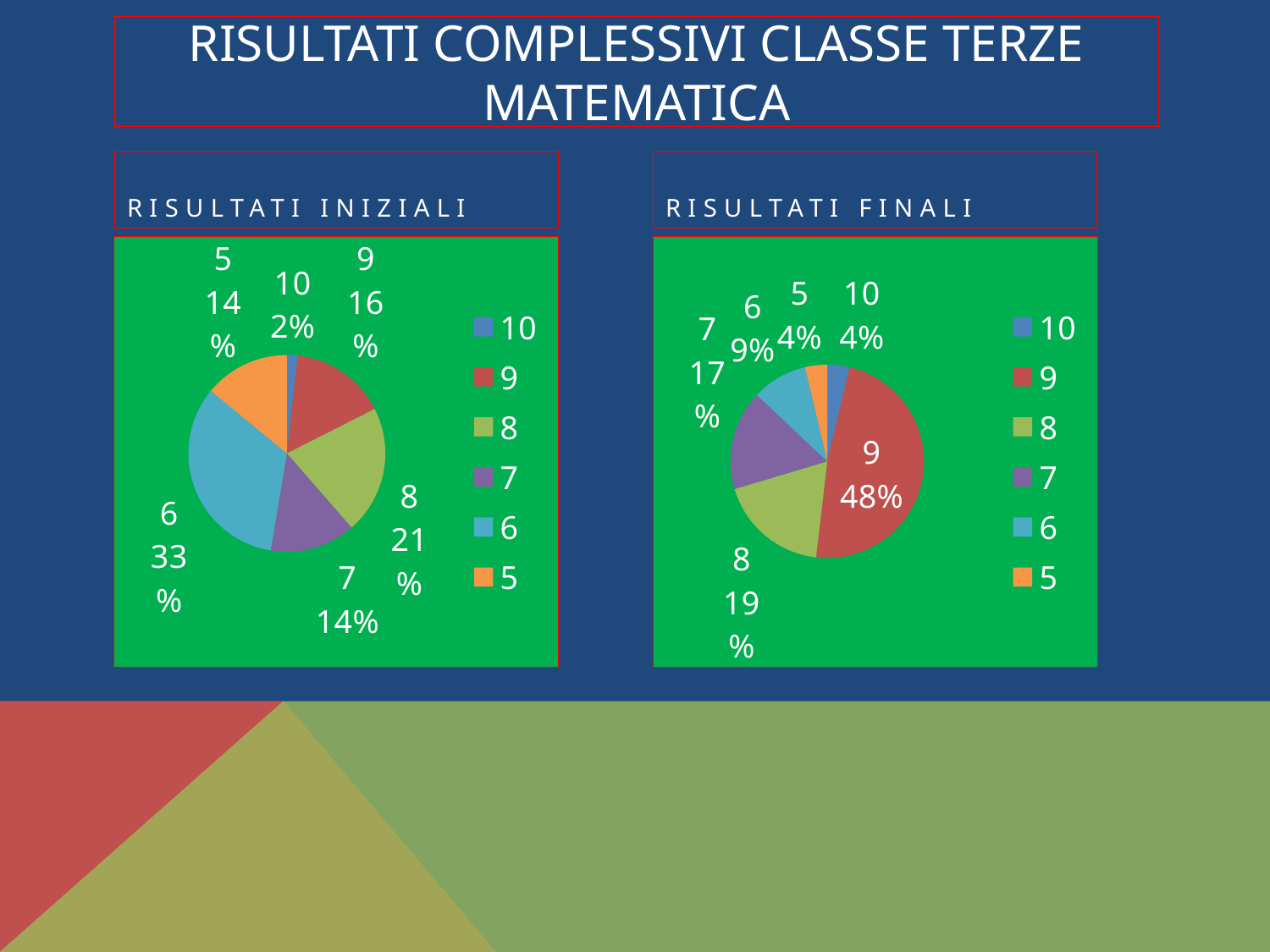
In the RISULTATI FINALI chart, what percentage is shown for grade 9? 48% In the RISULTATI INIZIALI chart, which is larger: the share for grade 9 or the share for grade 7? 9 In the RISULTATI FINALI chart, what is the difference in percentage points between grade 9 and grade 8? 29 How many entries does the legend of the RISULTATI INIZIALI chart list? 6 In the RISULTATI INIZIALI chart, which grade has the smallest share? 10 What type of chart is used for RISULTATI FINALI? Pie chart How many slices does the RISULTATI FINALI pie chart have? 6 In the RISULTATI FINALI chart, what percentage is shown for grade 7? 17% In the RISULTATI FINALI chart, which grade has the largest share? 9 In the RISULTATI INIZIALI chart, which grade has the largest share? 6 In the RISULTATI INIZIALI chart, what percentage is shown for grade 8? 21% In the RISULTATI INIZIALI chart, what percentage is shown for grade 6? 33%